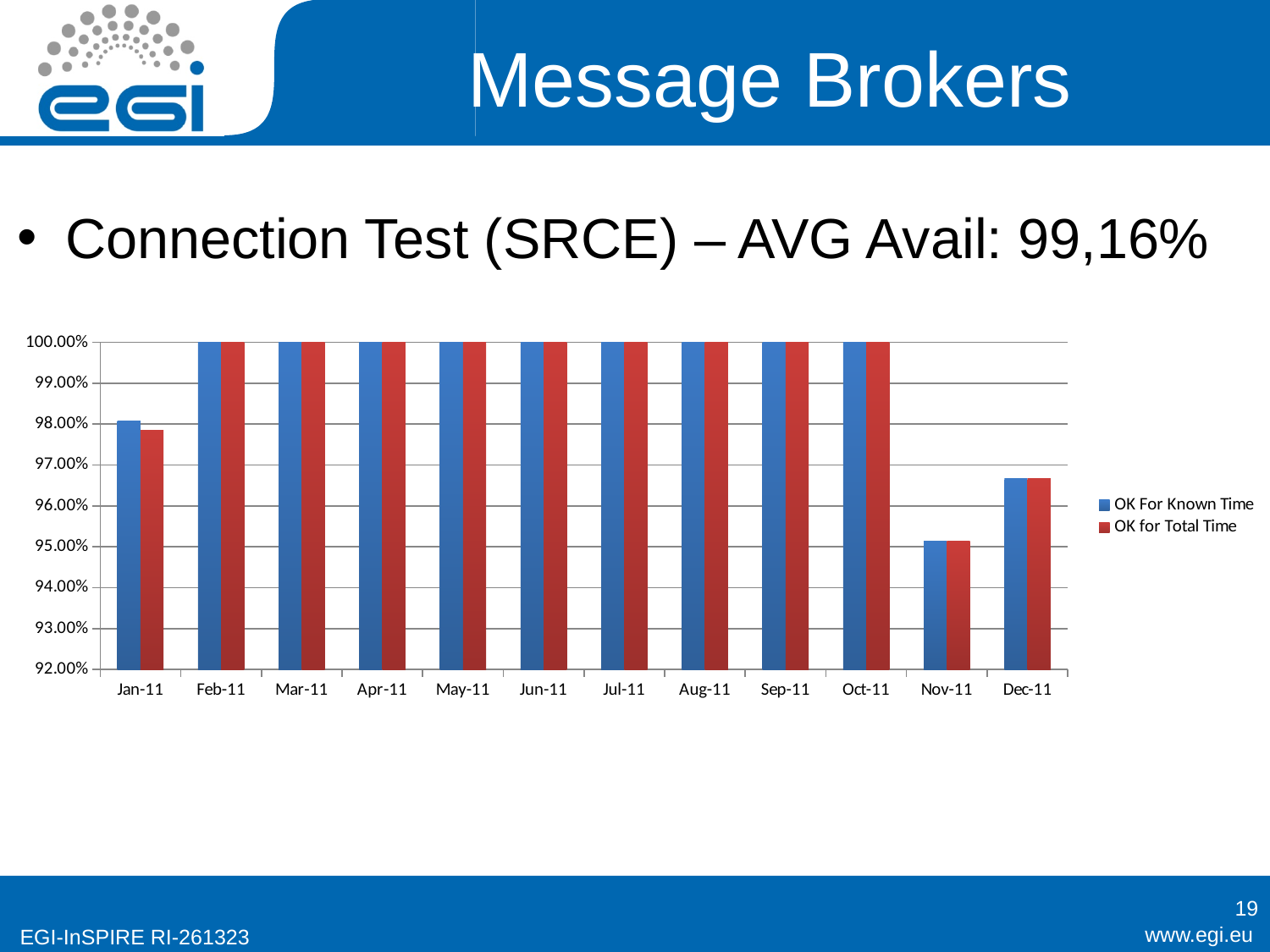
What is the value of OK for Total Time for Oct-11? 100.00% How many months are shown on the x axis of the chart? 12 Is the value of OK For Known Time for Dec-11 greater or less than 96.00%? greater Which month has the lowest value for OK For Known Time? Nov-11 What average availability is stated in the bullet text above the chart? 99,16% Is the value of OK For Known Time for Nov-11 greater or less than 96.00%? less How many series does the chart legend list? 2 What are the two series named in the chart legend? OK For Known Time and OK for Total Time What is the value of OK For Known Time for Feb-11? 100.00% Which is larger, the OK for Total Time value for Jan-11 or for Nov-11? Jan-11 Is the value of OK for Total Time for Jan-11 greater or less than 97.00%? greater What kind of chart is shown on the slide? bar chart